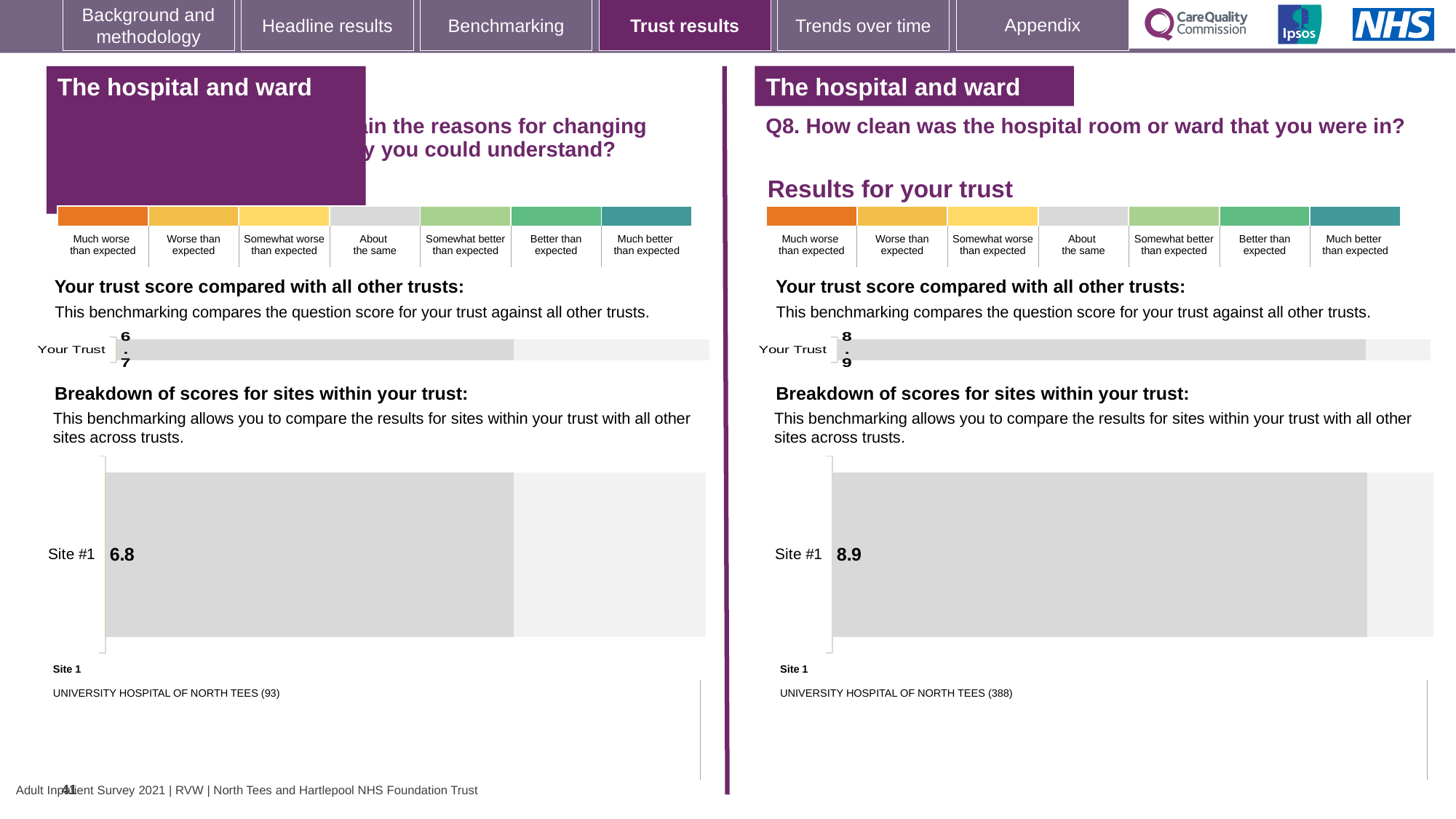
On the right-hand side of the slide (Q8), what is the score shown for Site #1 in the 'Breakdown of scores for sites within your trust' chart? 8.9 How many sites are shown in the 'Breakdown of scores for sites within your trust' chart on the right-hand side (Q8)? 1 Which site is listed as Site 1 under the right-hand (Q8) breakdown chart? UNIVERSITY HOSPITAL OF NORTH TEES (388) On the left-hand side of the slide, what is the score shown for Your Trust in the 'Your trust score compared with all other trusts' chart? 6.7 On the left-hand side of the slide, what is the score shown for Site #1 in the 'Breakdown of scores for sites within your trust' chart? 6.8 What is the difference between the Site #1 score on the right-hand chart (Q8) and the Site #1 score on the left-hand chart? 2.1 On the left-hand side of the slide, is the Site #1 score greater or less than the Your Trust score? greater What is the difference between the Your Trust score on the right-hand chart (Q8) and the Your Trust score on the left-hand chart? 2.2 On the right-hand side of the slide (Q8), what is the score shown for Your Trust in the 'Your trust score compared with all other trusts' chart? 8.9 Which has the higher Your Trust score: the left-hand chart or the right-hand chart (Q8)? The right-hand chart (Q8) What question is the right-hand side of the slide about? Q8. How clean was the hospital room or ward that you were in? What type of chart is used to show the Site #1 score on the left-hand side of the slide? Bar chart